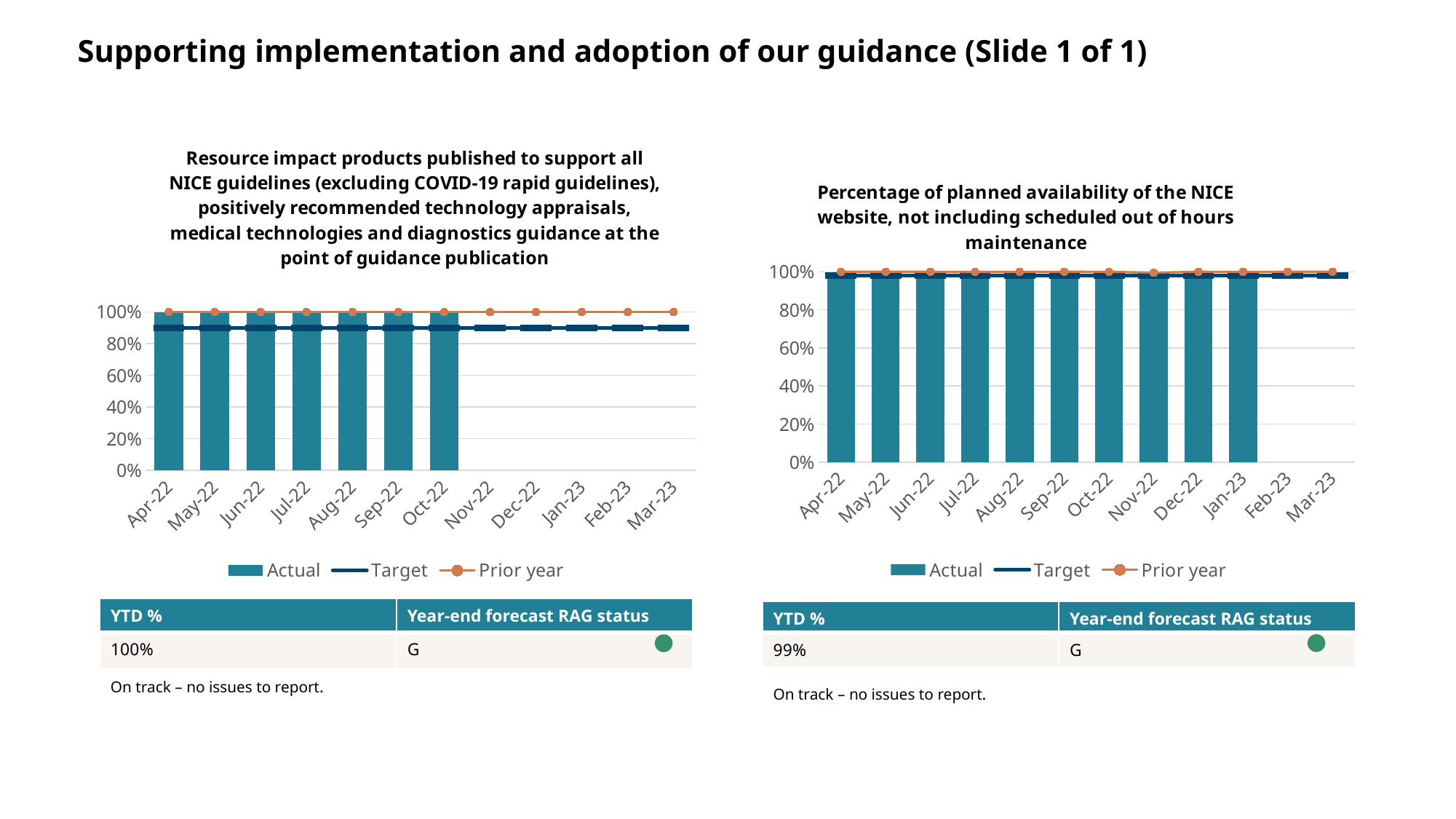
In the left chart, 'Resource impact products published...', what is the Actual value for Apr-22? 100% In the left chart, 'Resource impact products published...', is the Target value for Jun-22 greater or less than 80%? greater In the right chart, 'Percentage of planned availability of the NICE website', how many months have an Actual bar plotted? 10 What kind of chart is the left chart, 'Resource impact products published to support all NICE guidelines...'? Combination bar and line chart In the right chart, 'Percentage of planned availability of the NICE website', is the Actual value for Sep-22 greater or less than 80%? greater How many series does the legend of the right chart, 'Percentage of planned availability of the NICE website', list? 3 What are the three legend entries of the left chart, 'Resource impact products published...'? Actual, Target, Prior year In the left chart, 'Resource impact products published...', how many months have an Actual bar plotted? 7 In the left chart, 'Resource impact products published...', is the Target value for Dec-22 greater or less than 100%? less What is the last month label on the x axis of the right chart, 'Percentage of planned availability of the NICE website'? Mar-23 In the left chart, 'Resource impact products published...', which is higher for Apr-22: the Target or the Prior year value? Prior year How many months are shown on the x axis of the left chart, 'Resource impact products published...'? 12